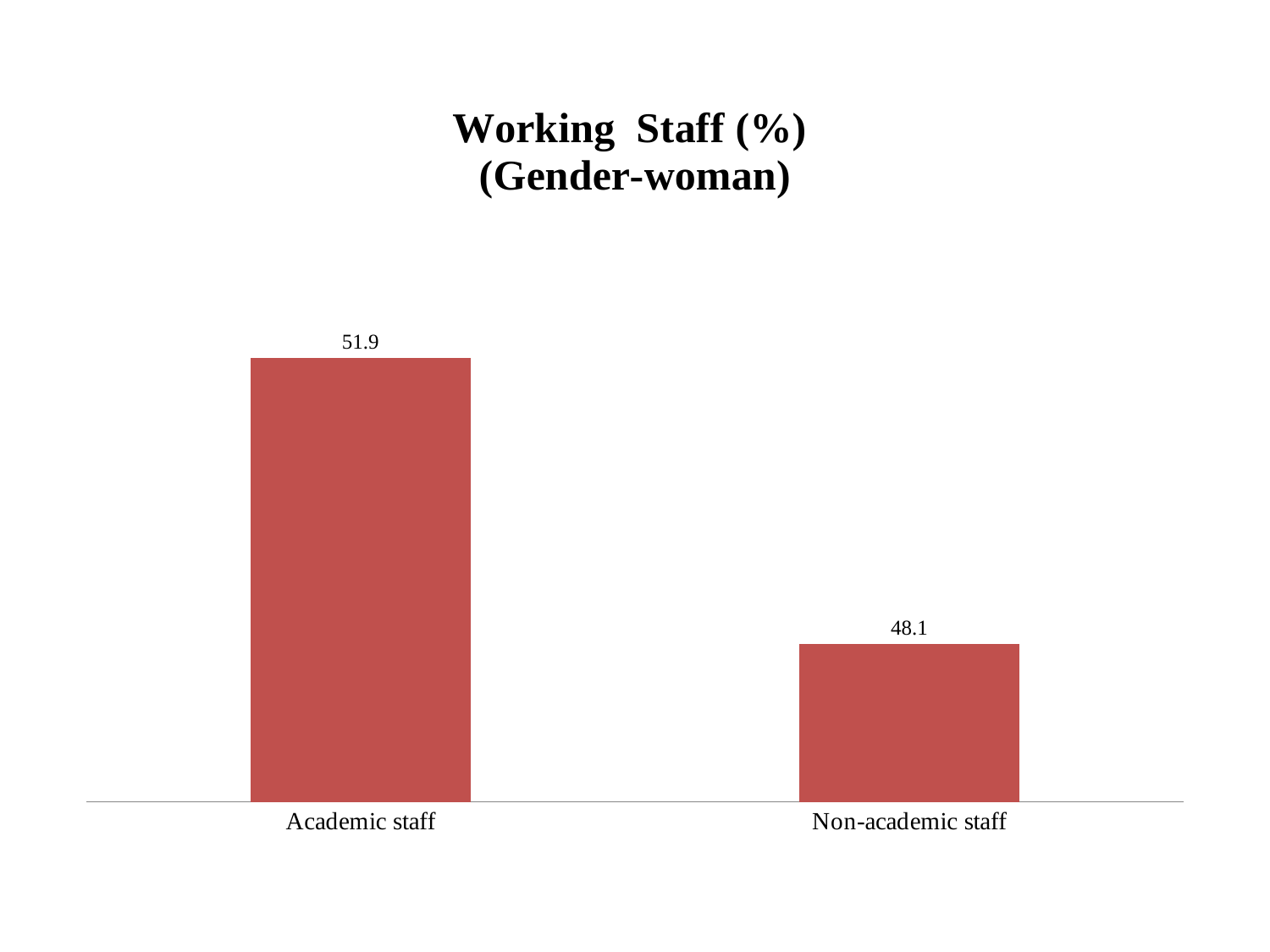
What is the title of the chart? Working Staff (%) (Gender-woman) What is the value for Academic staff? 51.9 Which category has the lowest value? Non-academic staff How many categories are shown in the chart? 2 What kind of chart is shown on the slide? Bar chart Which is larger, the value for Academic staff or the value for Non-academic staff? Academic staff Which category has the highest value? Academic staff What colour are the bars in the chart? Red What is the total of the two values shown in the chart? 100 What is the value for Non-academic staff? 48.1 What is the difference between the values for Academic staff and Non-academic staff? 3.8